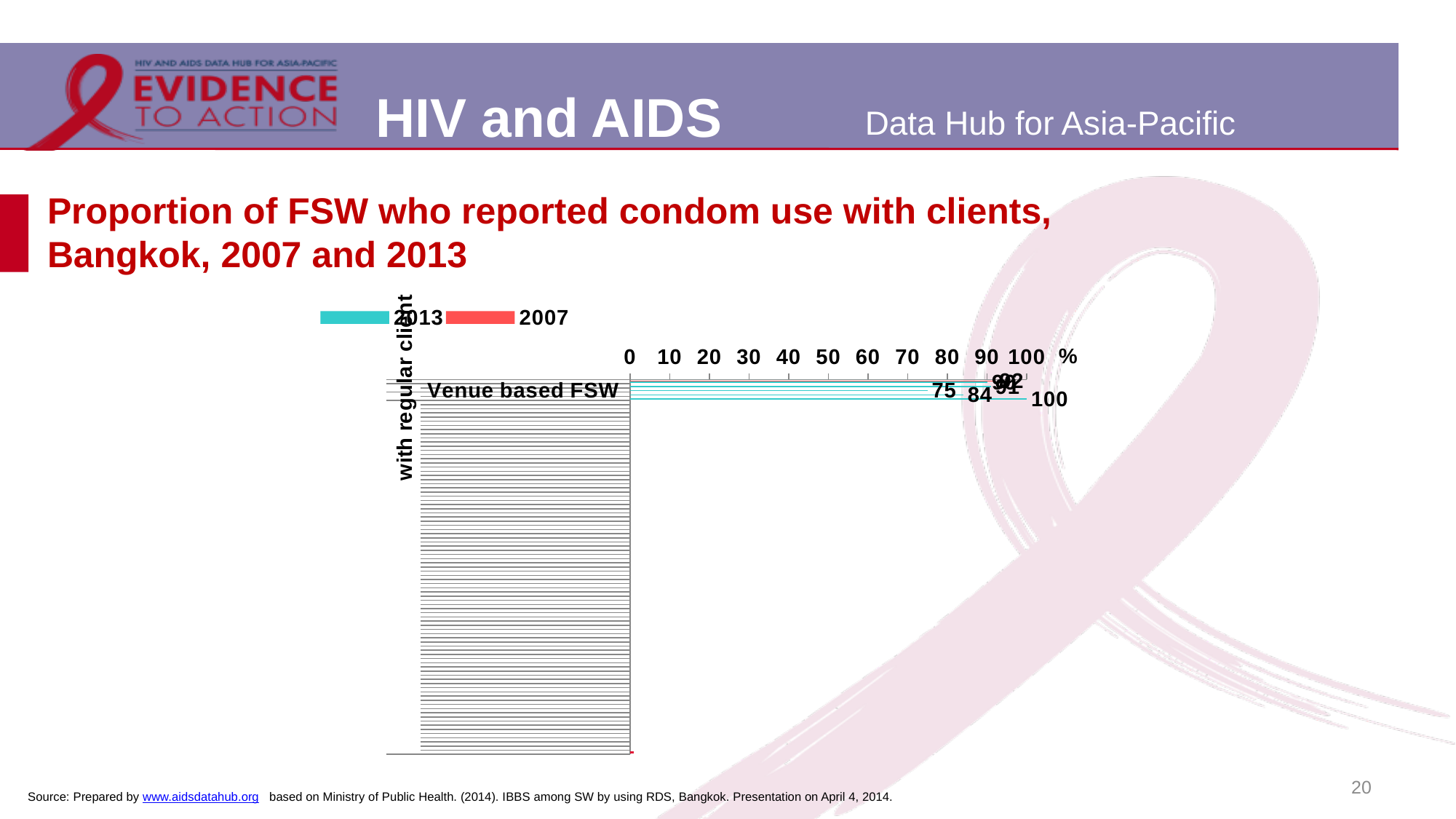
What kind of chart is shown on the slide? bar chart What is the highest value shown on the chart's horizontal axis? 100 What unit is indicated at the end of the chart's horizontal axis? % What is the name of the category label readable on the chart? Venue based FSW How many series does the chart legend list? 2 Which two years are listed in the chart legend? 2013 and 2007